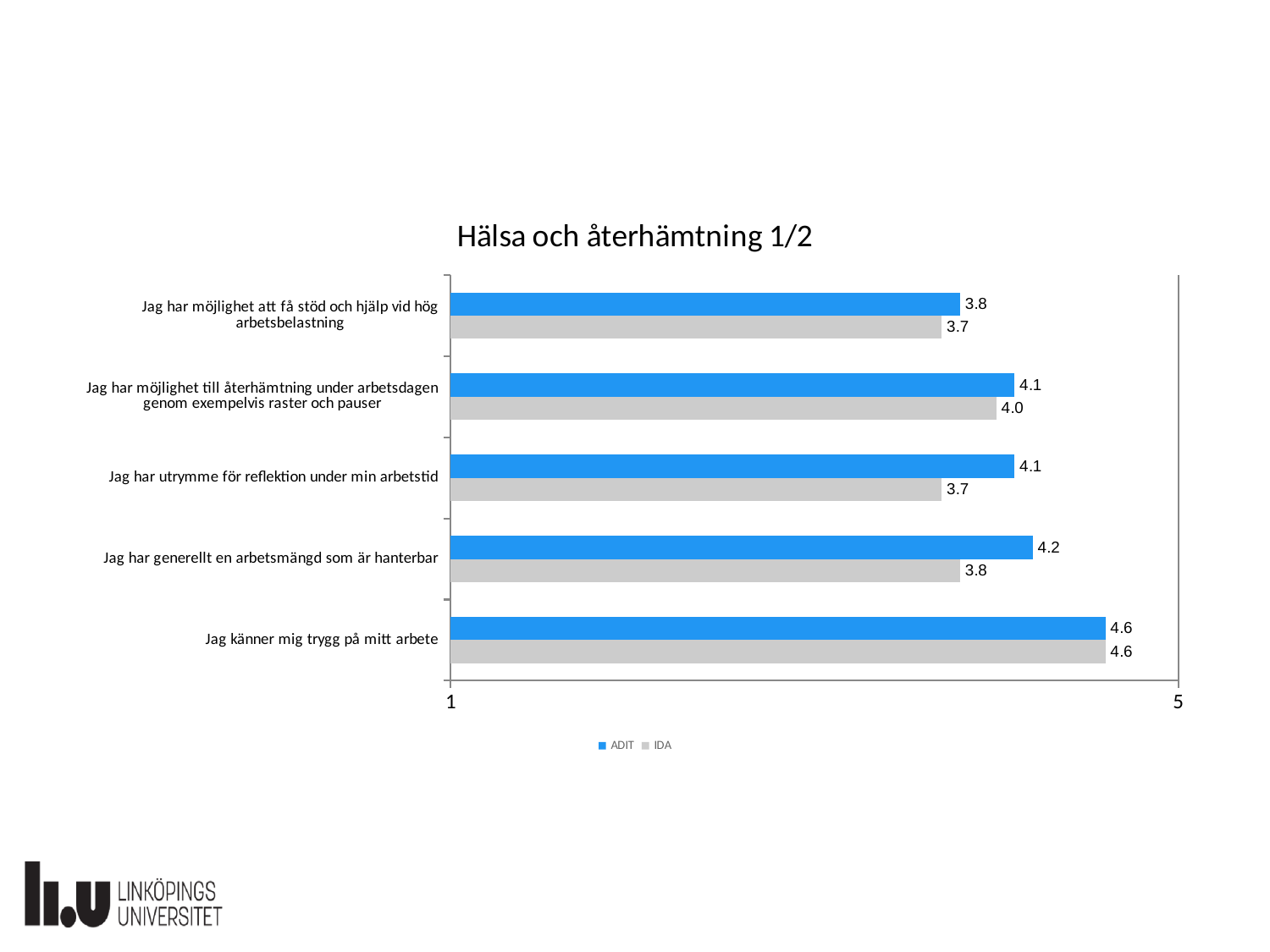
What is the ADIT value for "Jag har generellt en arbetsmängd som är hanterbar"? 4.2 What kind of chart is shown on the slide? Bar chart What is the title of the chart? Hälsa och återhämtning 1/2 How many categories are shown in the chart? 5 For "Jag har möjlighet att få stöd och hjälp vid hög arbetsbelastning", which series has the larger value, ADIT or IDA? ADIT Which category has the lowest ADIT value? Jag har möjlighet att få stöd och hjälp vid hög arbetsbelastning What is the IDA value for "Jag har utrymme för reflektion under min arbetstid"? 3.7 What is the difference between the ADIT and IDA values for "Jag har utrymme för reflektion under min arbetstid"? 0.4 Which category has the highest ADIT value? Jag känner mig trygg på mitt arbete What is the difference between the ADIT and IDA values for "Jag har generellt en arbetsmängd som är hanterbar"? 0.4 How many series does the legend list? 2 What is the IDA value for "Jag har möjlighet till återhämtning under arbetsdagen genom exempelvis raster och pauser"? 4.0